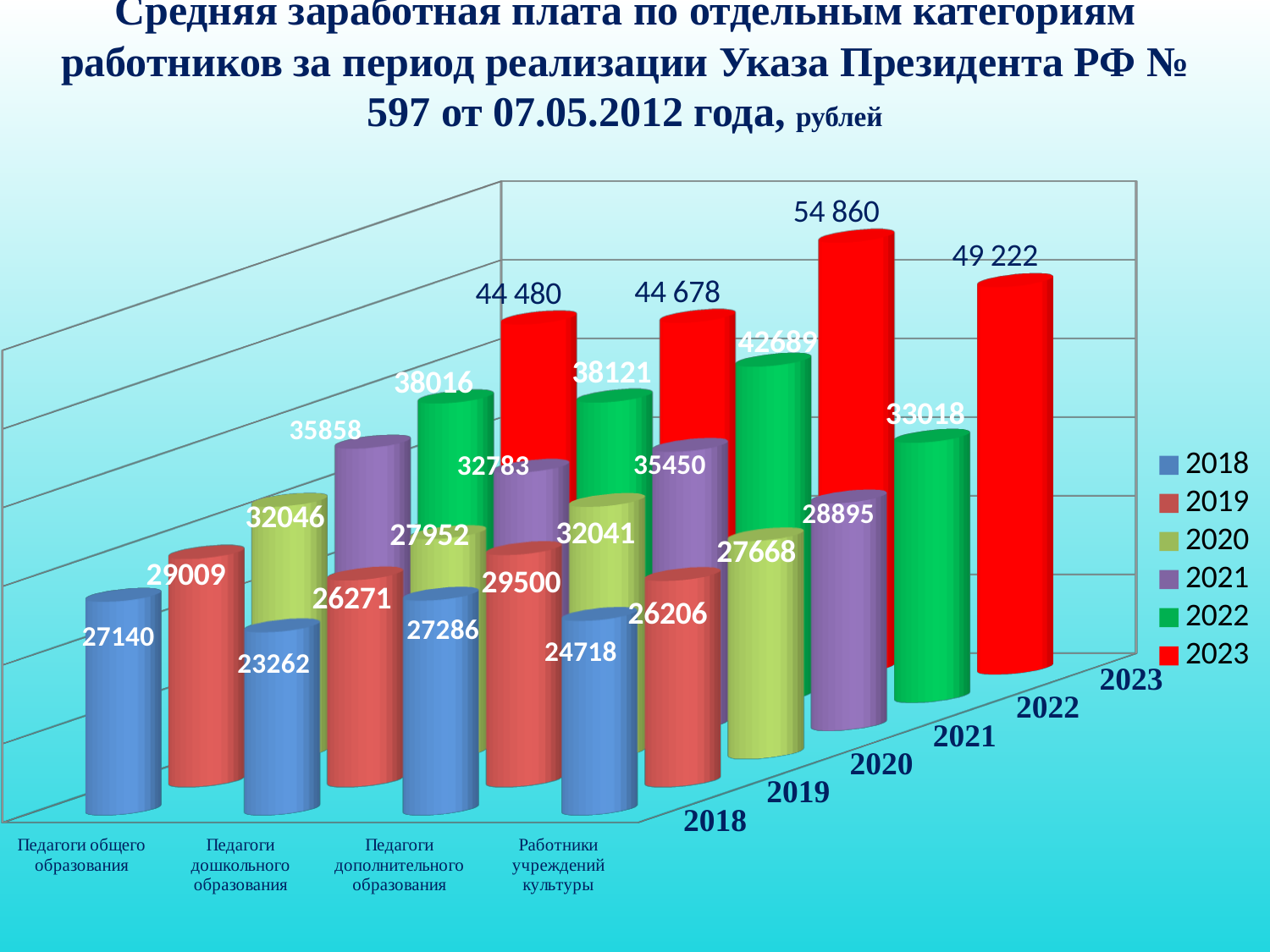
Which category has the highest 2023 value? Педагоги дополнительного образования What is the 2018 value for Педагоги общего образования? 27140 How many series does the legend list? 6 What is the 2022 value for Работники учреждений культуры? 33018 Which category has the lowest 2018 value? Педагоги дошкольного образования Which is larger: the 2022 value for Педагоги общего образования or the 2022 value for Педагоги дошкольного образования? Педагоги дошкольного образования Do the values for Педагоги общего образования rise or fall from 2018 to 2023? Rise What is the 2023 value for Педагоги дополнительного образования? 54 860 How many categories are shown on the x axis? 4 What kind of chart is this? Bar chart What is the 2021 value for Педагоги дошкольного образования? 32783 What is the difference between the 2023 and 2018 values for Работники учреждений культуры? 24 504